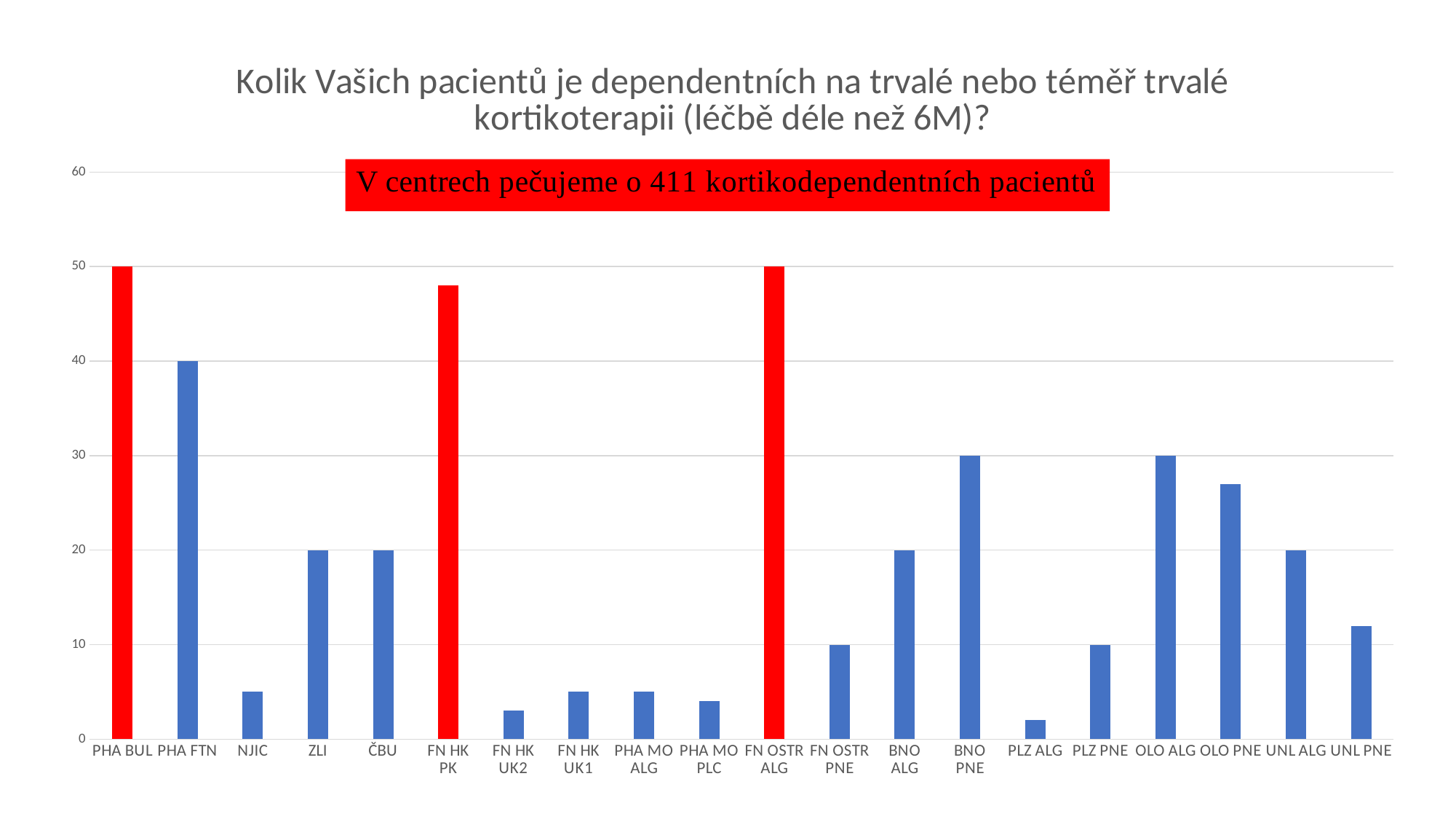
Is the value for FN HK PK greater or less than 40? greater How many categories (centres) are shown on the x axis? 20 What is the difference between the values for PHA FTN and ZLI? 20 Which is larger, the value for PHA FTN or the value for BNO PNE? PHA FTN What total number of corticodependent patients does the red box on the slide state? 411 What is the value for PHA FTN? 40 What is the value for ZLI? 20 What type of chart is shown on the slide? bar chart What is the value for PHA BUL? 50 Is the value for OLO PNE greater or less than 30? less Which category has the lowest value? PLZ ALG What is the value for BNO PNE? 30